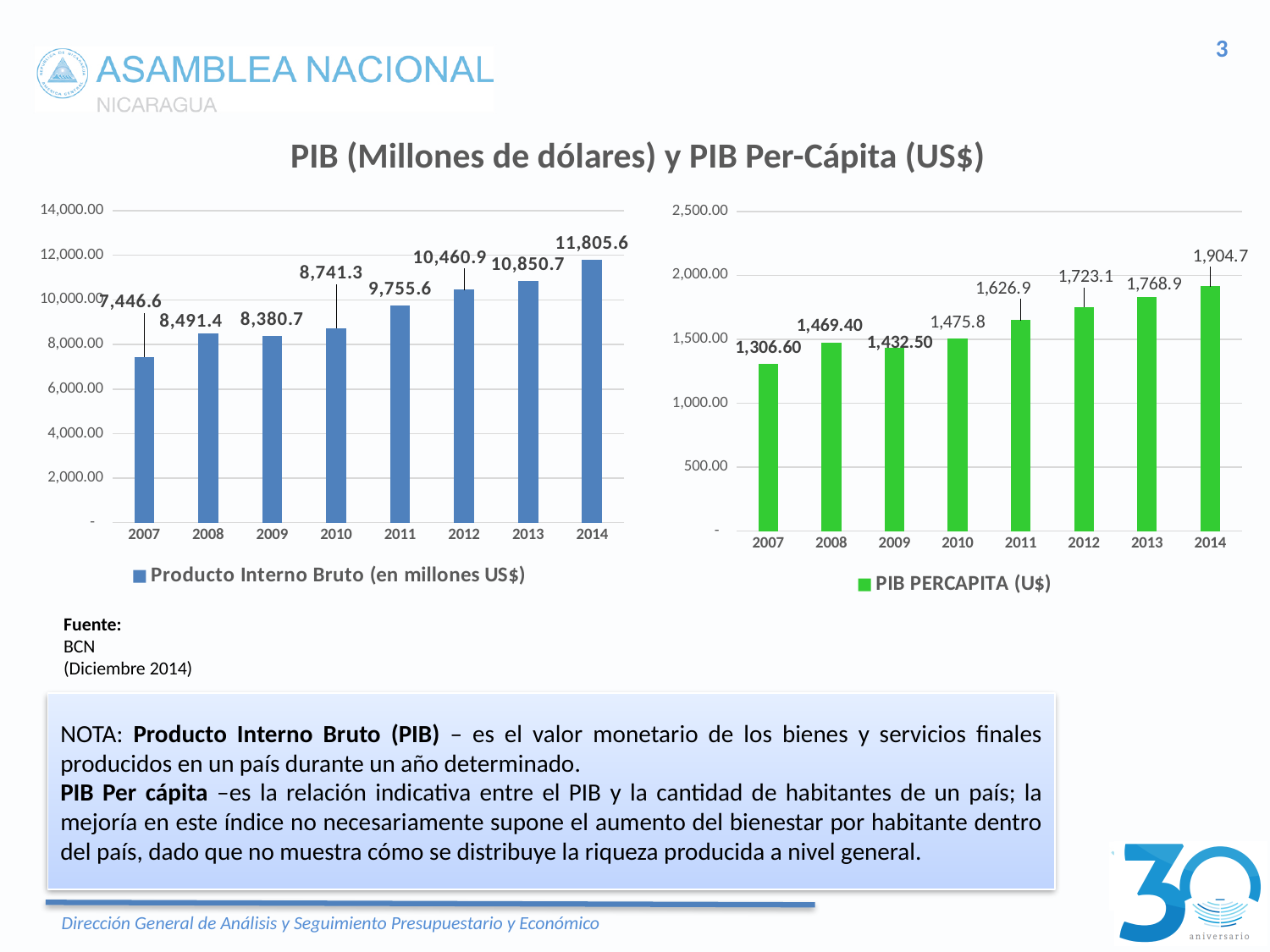
In the left chart (Producto Interno Bruto), which year has the highest value? 2014 In the right chart (PIB PERCAPITA), is the value for 2012 greater or less than 1,500.00? greater In the left chart (Producto Interno Bruto), what is the value for 2007? 7,446.6 In the right chart (PIB PERCAPITA), which year has the lowest value? 2007 How many years are shown on the x axis of the left chart (Producto Interno Bruto)? 8 In the left chart (Producto Interno Bruto), which year has the larger value, 2008 or 2009? 2008 In the right chart (PIB PERCAPITA), what is the difference between the 2014 and 2007 values? 598.1 In the left chart (Producto Interno Bruto), what is the difference between the 2014 and 2013 values? 954.9 What is the title shown above the two charts? PIB (Millones de dólares) y PIB Per-Cápita (US$) In the right chart (PIB PERCAPITA), what is the value for 2011? 1,626.9 In the left chart (Producto Interno Bruto), what is the value for 2014? 11,805.6 What type of chart is the right chart (PIB PERCAPITA)? bar chart